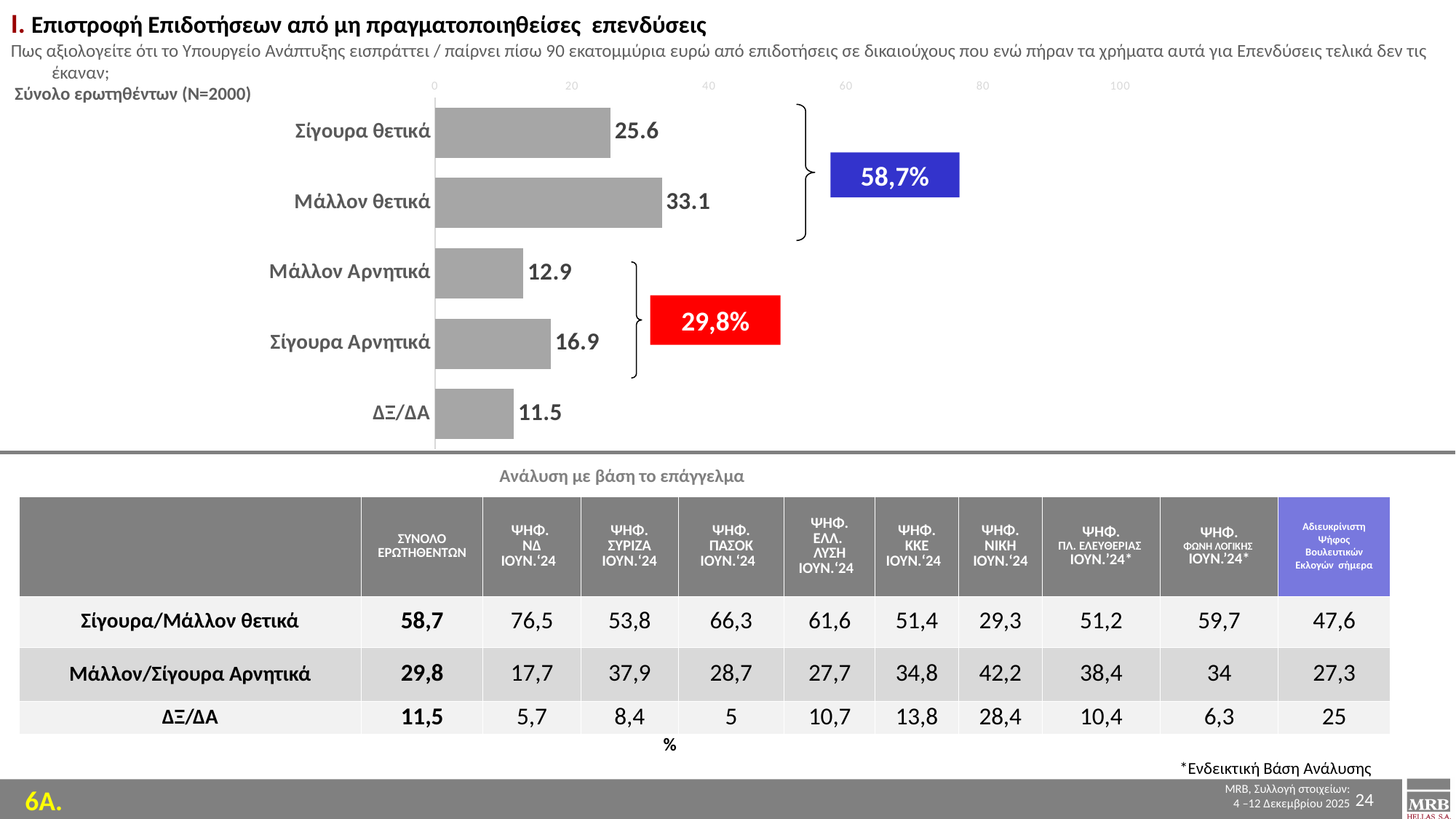
How many categories are shown in the bar chart? 5 What kind of chart is shown on the slide? bar chart What percentage is shown in the blue callout box next to the positive bars? 58,7% What is the difference between the values for Μάλλον θετικά and Σίγουρα θετικά? 7.5 Which is larger in the bar chart: Σίγουρα Αρνητικά or Μάλλον Αρνητικά? Σίγουρα Αρνητικά What is the value for Μάλλον θετικά in the bar chart? 33.1 What is the value for ΔΞ/ΔΑ in the bar chart? 11.5 Is the value for Μάλλον θετικά greater or less than 40? less What is the value for Σίγουρα Αρνητικά in the bar chart? 16.9 Which category has the highest value in the bar chart? Μάλλον θετικά Which category has the lowest value in the bar chart? ΔΞ/ΔΑ What is the value for Σίγουρα θετικά in the bar chart? 25.6